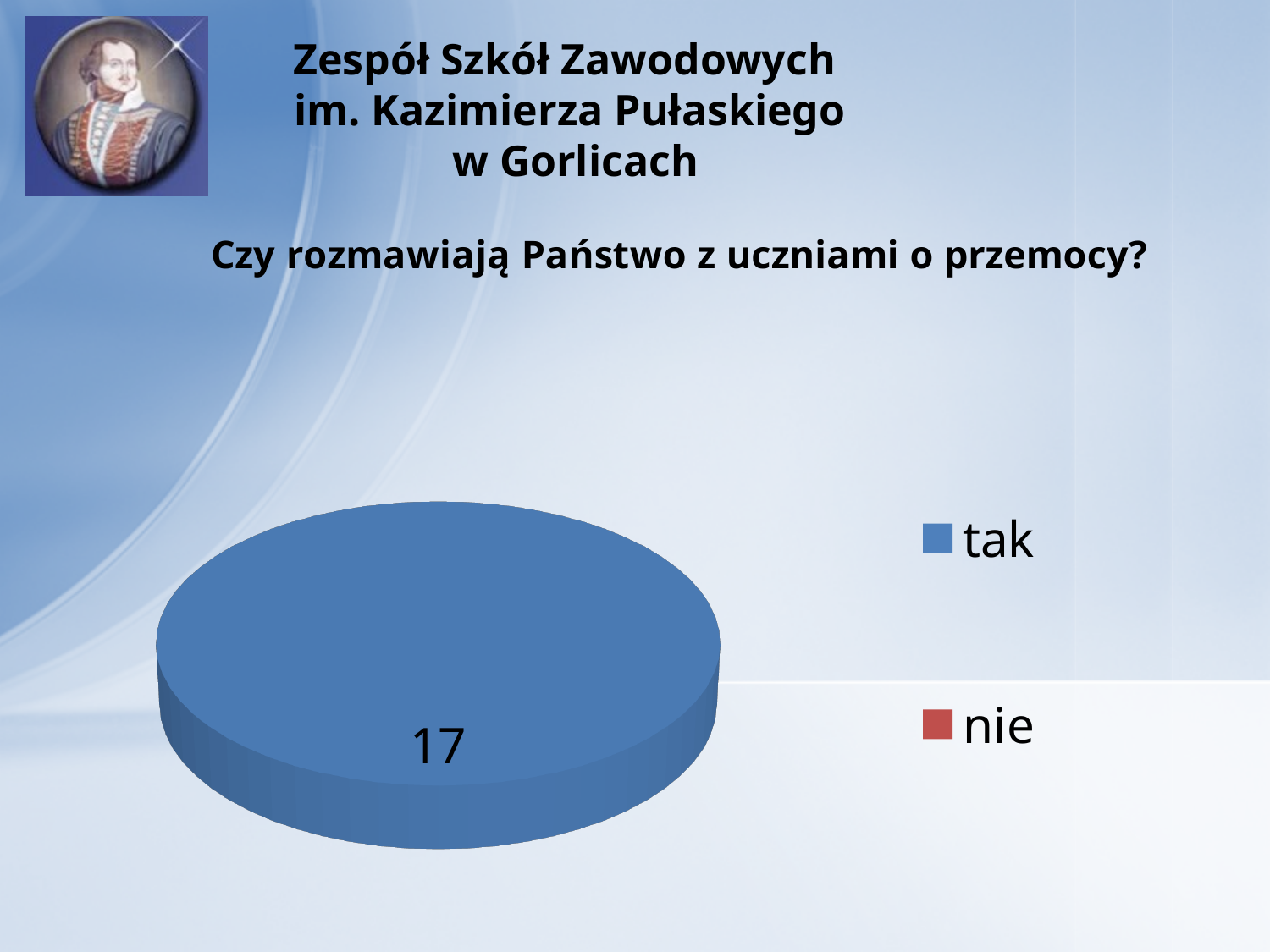
How many entries does the chart legend list? 2 Which category is larger in the pie chart, "tak" or "nie"? tak What question is the chart on the slide about? Czy rozmawiają Państwo z uczniami o przemocy? Which category has the smallest share of the pie chart? nie What value is shown for the "tak" slice of the pie chart? 17 Is the value for "tak" greater or less than 10? greater What kind of chart is shown on the slide? pie chart Which category has the largest slice in the pie chart? tak What colour is the "tak" slice in the pie chart? blue